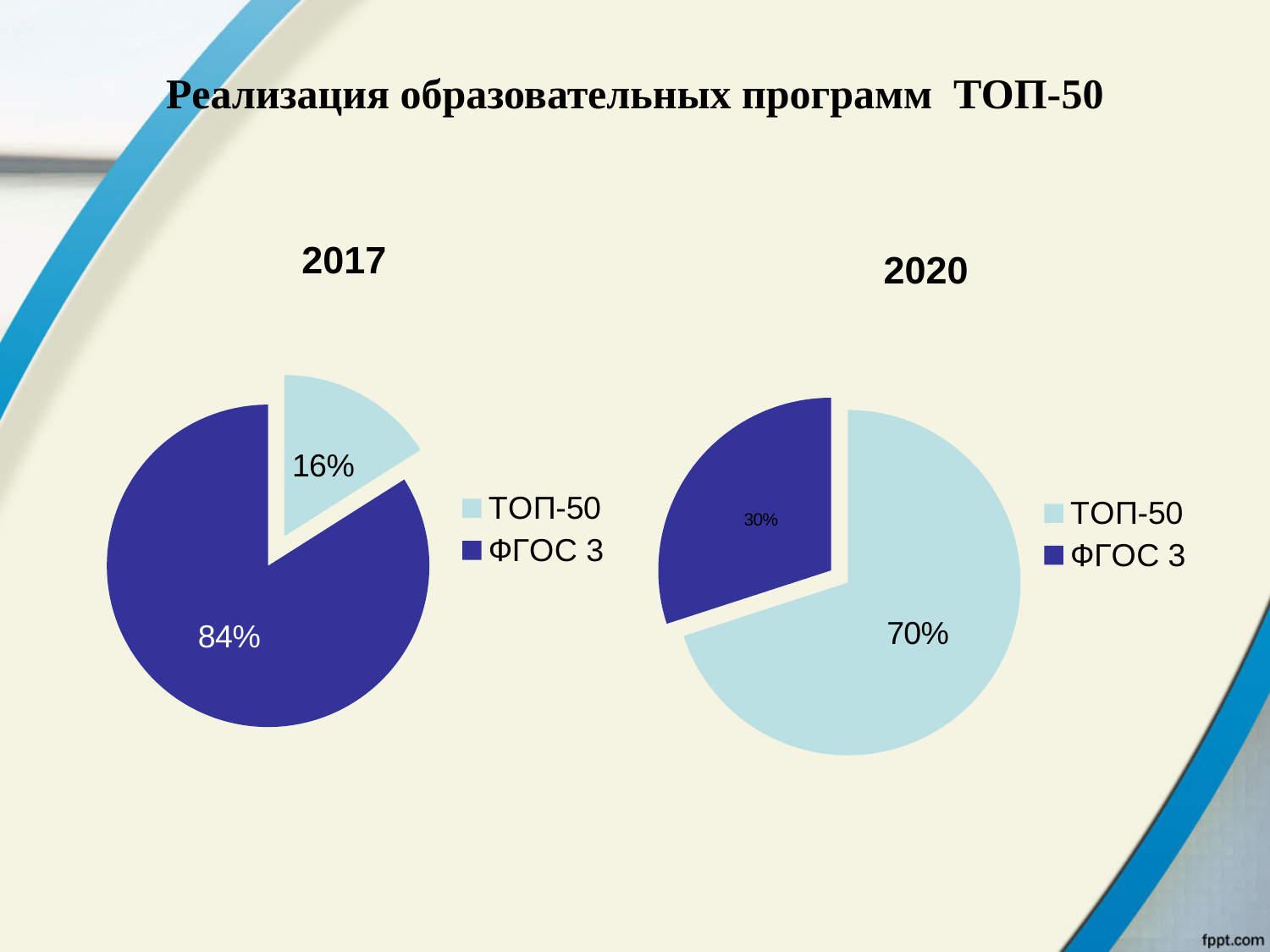
In the 2020 pie chart, what share does ТОП-50 have? 70% In the 2020 pie chart, what is the difference between the ТОП-50 share and the ФГОС 3 share? 40% In the 2020 pie chart, which is larger: ТОП-50 or ФГОС 3? ТОП-50 In the 2017 pie chart, what is the difference between the ФГОС 3 share and the ТОП-50 share? 68% What type of chart is used for the 2017 data? Pie chart In the 2017 pie chart, what share does ФГОС 3 have? 84% In the 2017 pie chart, what share does ТОП-50 have? 16% In the 2017 pie chart, which category has the largest slice? ФГОС 3 In the 2020 pie chart, what share does ФГОС 3 have? 30% How many slices does the 2020 pie chart have? 2 In the 2020 pie chart, which category has the smallest slice? ФГОС 3 How many entries does the legend of the 2017 pie chart list? 2